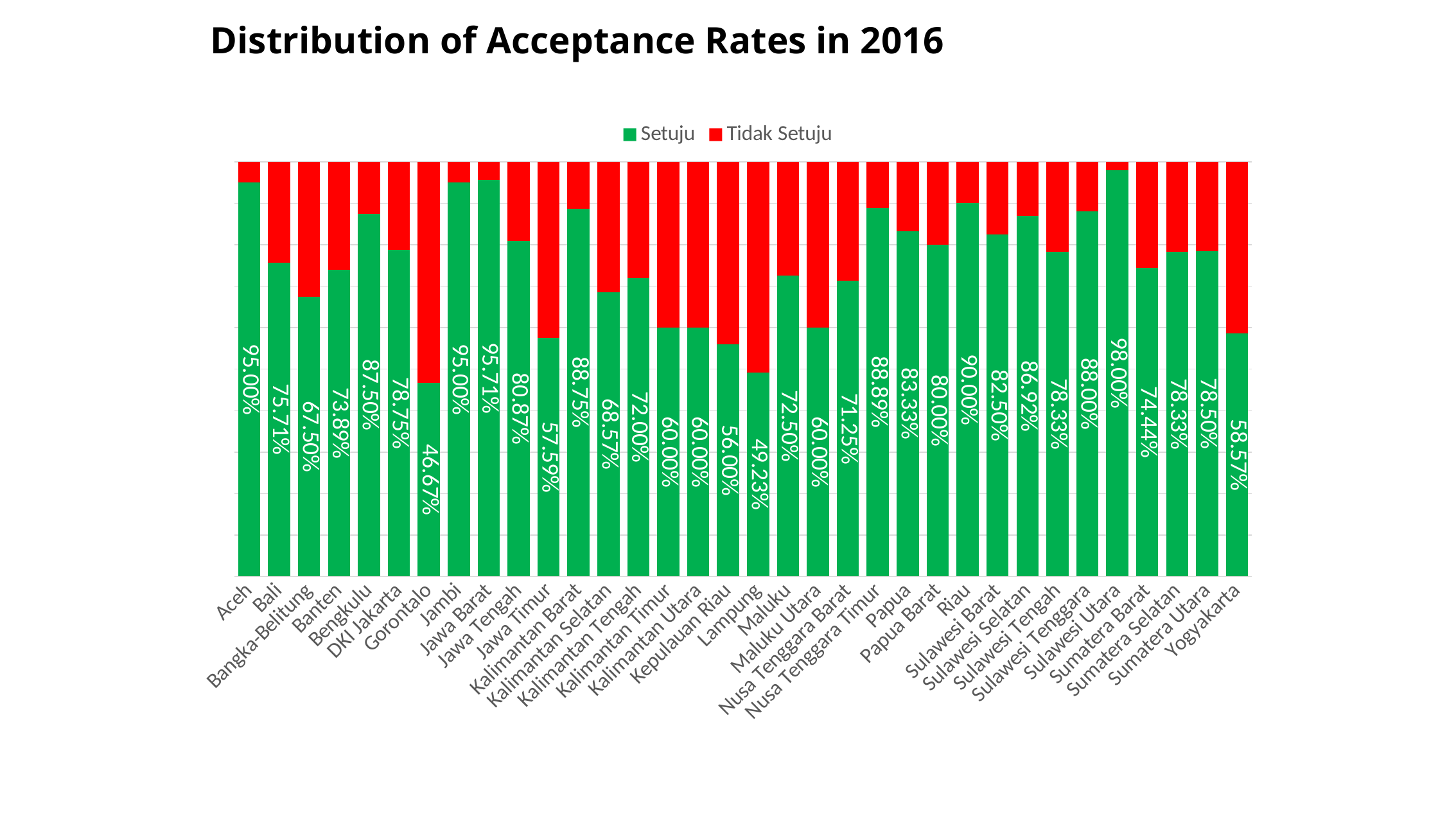
What is the Setuju value for Gorontalo? 46.67% How many series does the legend list? 2 Which has a larger Setuju value, Lampung or Kepulauan Riau? Kepulauan Riau What kind of chart is this? Stacked bar chart What is the Setuju value for Aceh? 95.00% What is the Setuju value for Sulawesi Selatan? 86.92% Which province has the highest Setuju value? Sulawesi Utara What is the title of the chart? Distribution of Acceptance Rates in 2016 How many provinces are shown on the x axis? 34 Which province has the lowest Setuju value? Gorontalo Which has a larger Setuju value, Jawa Barat or Jambi? Jawa Barat What is the difference between the Setuju values for Riau and Papua Barat? 10.00%